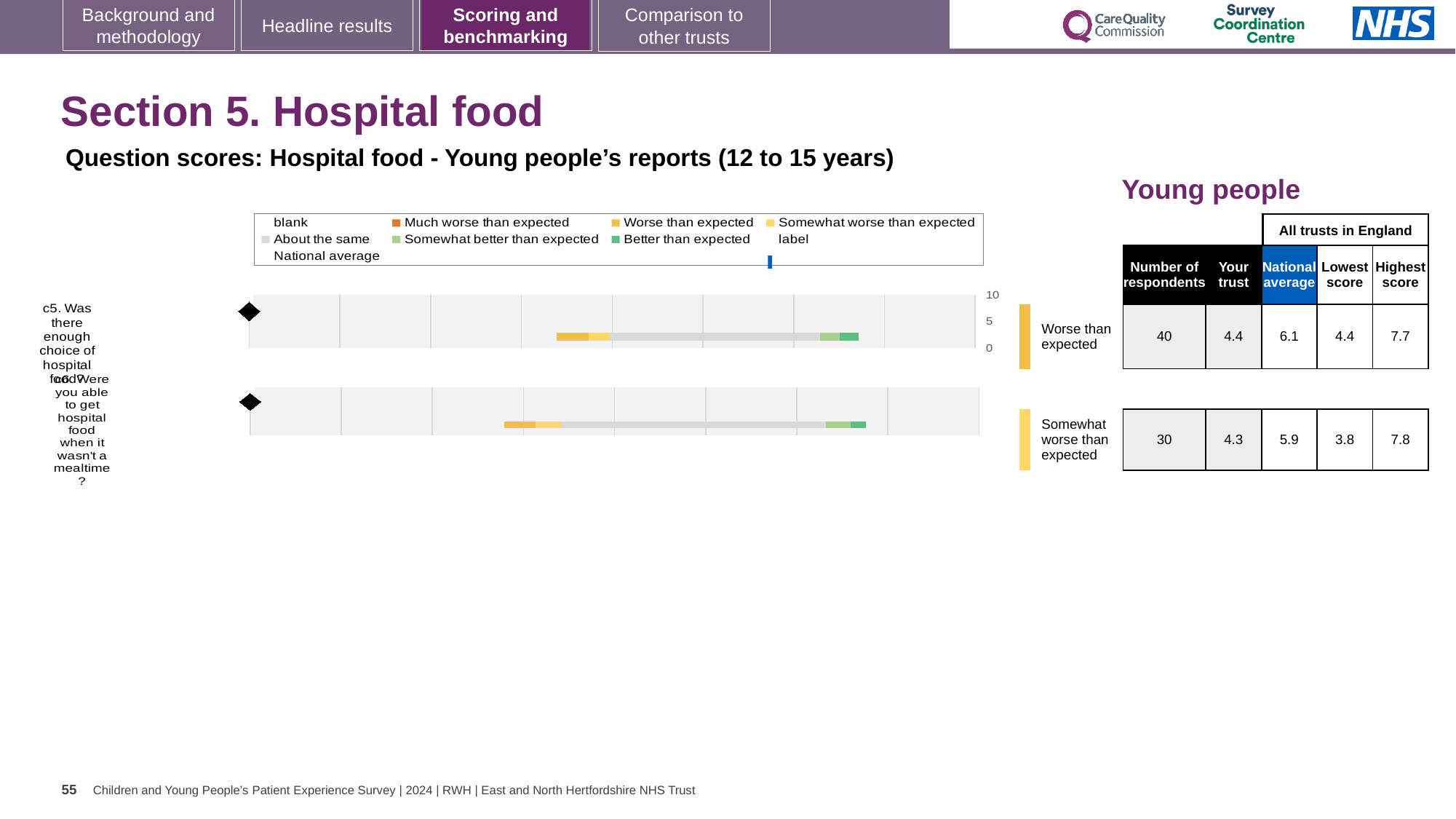
How many respondents answered question c5? 40 According to the table beside the chart, what is the 'Your trust' score for c5 (Was there enough choice of hospital food?)? 4.4 What is the difference between the national average and the trust's score for c6? 1.6 What kind of chart is used to show the question scores for hospital food? bar chart Which benchmark category is the trust's result for c6 placed in? Somewhat worse than expected What is the national average score for c6 (Were you able to get hospital food when it wasn't a mealtime?)? 5.9 How many questions (categories) are plotted in the hospital food chart? 2 What is the highest score across all trusts in England for c6? 7.8 Is the trust's score for c5 greater or less than 5 on the chart axis? less Which question had more respondents, c5 or c6? c5 What is the difference between the national average and the trust's score for c5? 1.7 Which is larger for c5: the trust's score or the national average? National average